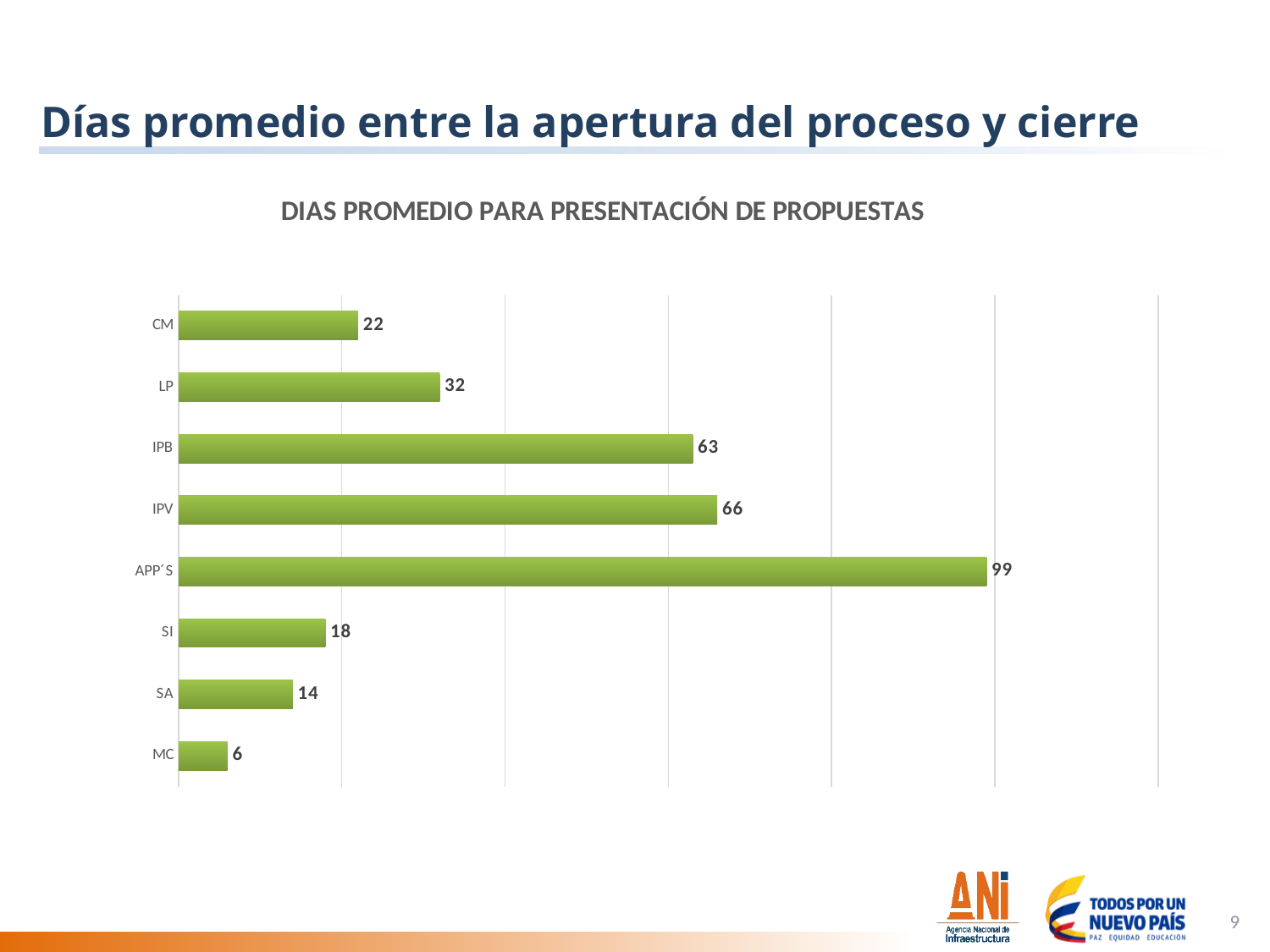
Which category has the highest value? APP´S What is the value for IPB? 63 What is the value for APP´S? 99 What kind of chart is shown on the slide? bar chart What is the difference between the values for IPV and IPB? 3 How many categories are shown in the chart? 8 What colour are the bars in the chart? green What is the title of the chart? DIAS PROMEDIO PARA PRESENTACIÓN DE PROPUESTAS What is the difference between the values for LP and CM? 10 What is the value for SA? 14 Which category has the lowest value? MC Which is larger, the value for SI or the value for SA? SI